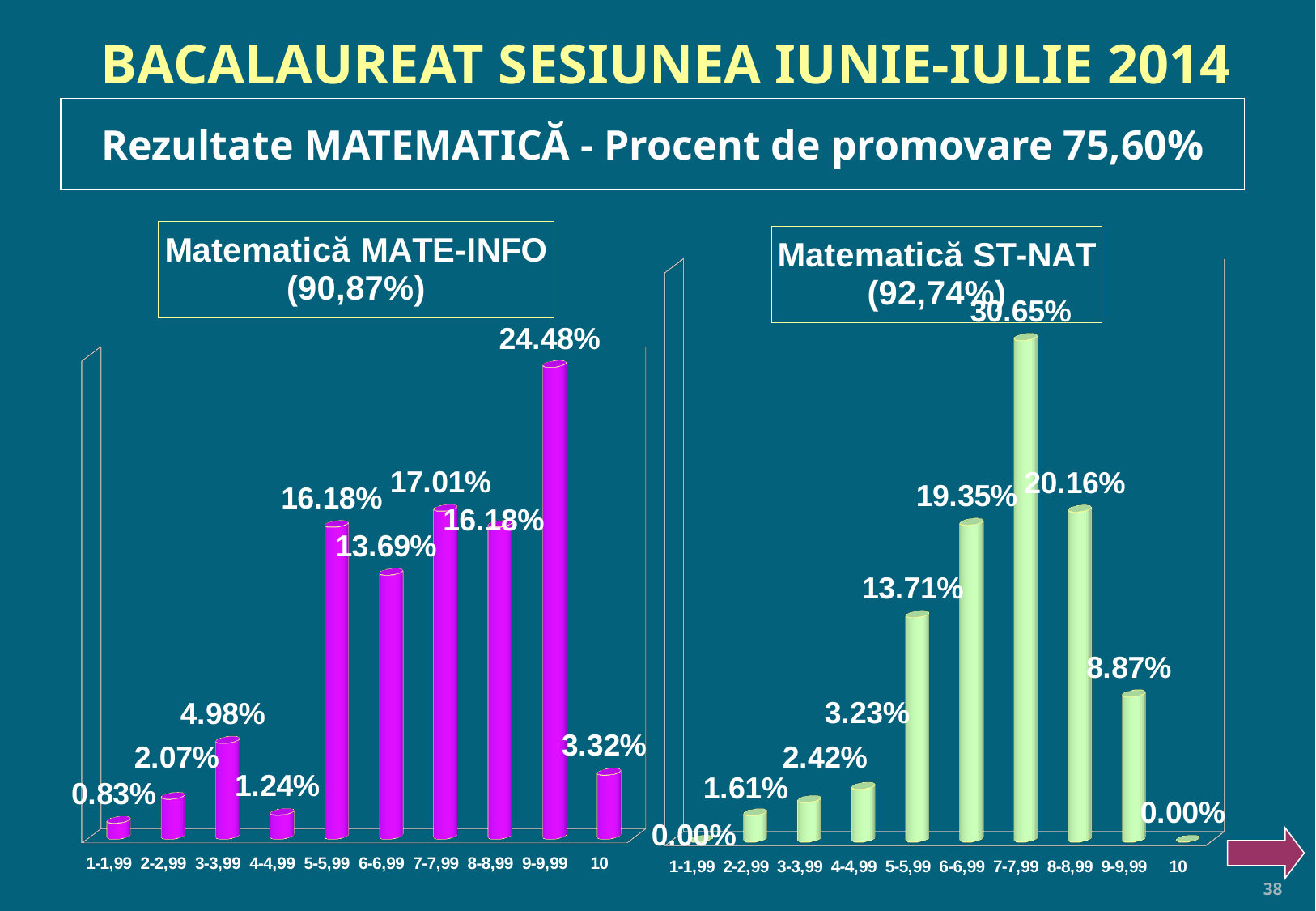
In the Matematică ST-NAT chart, what is the value for the 7-7,99 category? 30.65% In the Matematică ST-NAT chart, what is the value for the 5-5,99 category? 13.71% In the Matematică ST-NAT chart, what is the difference between the 7-7,99 value and the 8-8,99 value? 10.49% In the Matematică MATE-INFO chart, what is the value for the 9-9,99 category? 24.48% In the Matematică MATE-INFO chart, which category has the lowest value? 1-1,99 What kind of chart is the Matematică MATE-INFO chart? Bar chart In the Matematică MATE-INFO chart, what is the value for the 10 category? 3.32% How many categories are shown on the x axis of the Matematică ST-NAT chart? 10 In the Matematică ST-NAT chart, which category has the highest value? 7-7,99 In the Matematică MATE-INFO chart, which category has the highest value? 9-9,99 What percentage is shown in the title box of the Matematică ST-NAT chart? 92,74% In the Matematică MATE-INFO chart, which is larger: the value for 7-7,99 or the value for 6-6,99? 7-7,99